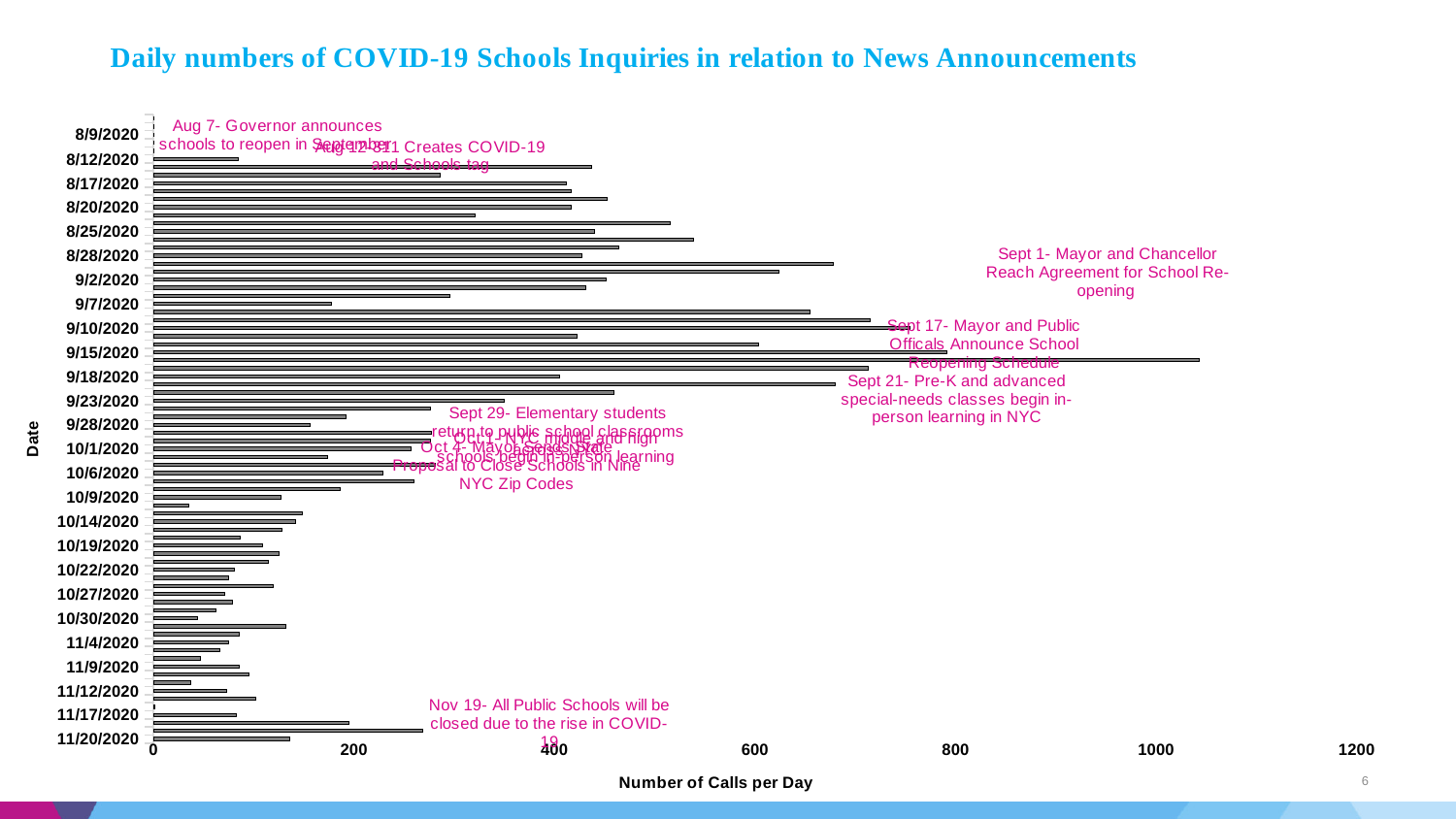
Is the value for 11/20/2020 greater or less than 200? less What is the label of the horizontal axis? Number of Calls per Day What is the title of the chart? Daily numbers of COVID-19 Schools Inquiries in relation to News Announcements Is the value for 8/9/2020 greater or less than 200? less Is the value for 10/14/2020 greater or less than 200? less Do the values generally rise or fall from 9/18/2020 to 11/20/2020? fall Which has the larger value, 8/9/2020 or 9/7/2020? 9/7/2020 What kind of chart is shown on the slide? bar chart Which has the larger value, 9/7/2020 or 11/20/2020? 9/7/2020